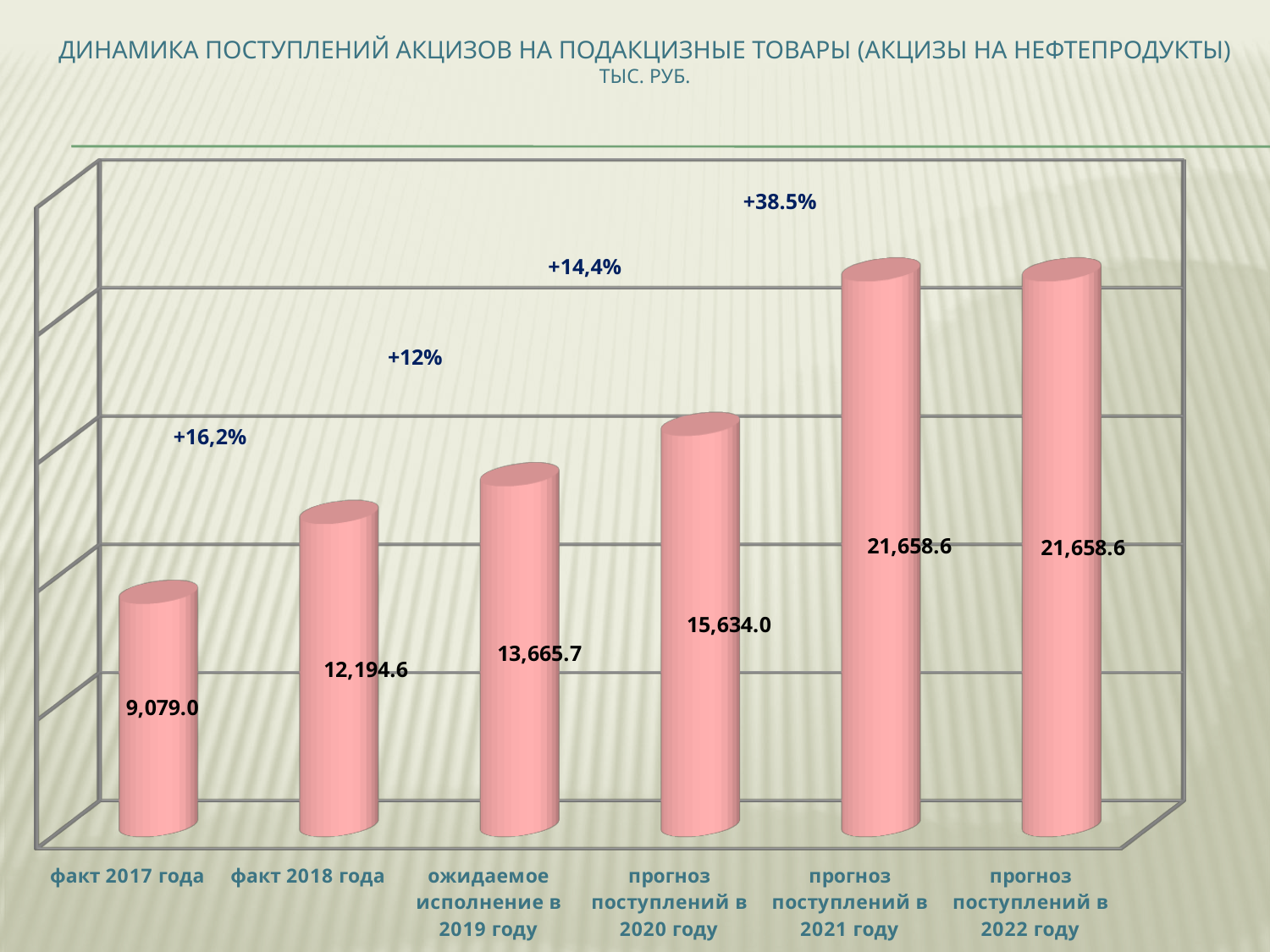
Which is larger, the value for ожидаемое исполнение в 2019 году or the value for факт 2018 года? ожидаемое исполнение в 2019 году What is the value for прогноз поступлений в 2020 году? 15,634.0 What is the difference between the values for прогноз поступлений в 2021 году and прогноз поступлений в 2020 году? 6,024.6 What percentage growth is annotated above the bar for прогноз поступлений в 2021 году? +38.5% What is the value for факт 2017 года? 9,079.0 What is the value for прогноз поступлений в 2022 году? 21,658.6 How many categories are shown on the x axis? 6 Which category has the lowest value? факт 2017 года What kind of chart is this? bar chart What is the value for ожидаемое исполнение в 2019 году? 13,665.7 What is the difference between the values for факт 2018 года and факт 2017 года? 3,115.6 What is the value for факт 2018 года? 12,194.6